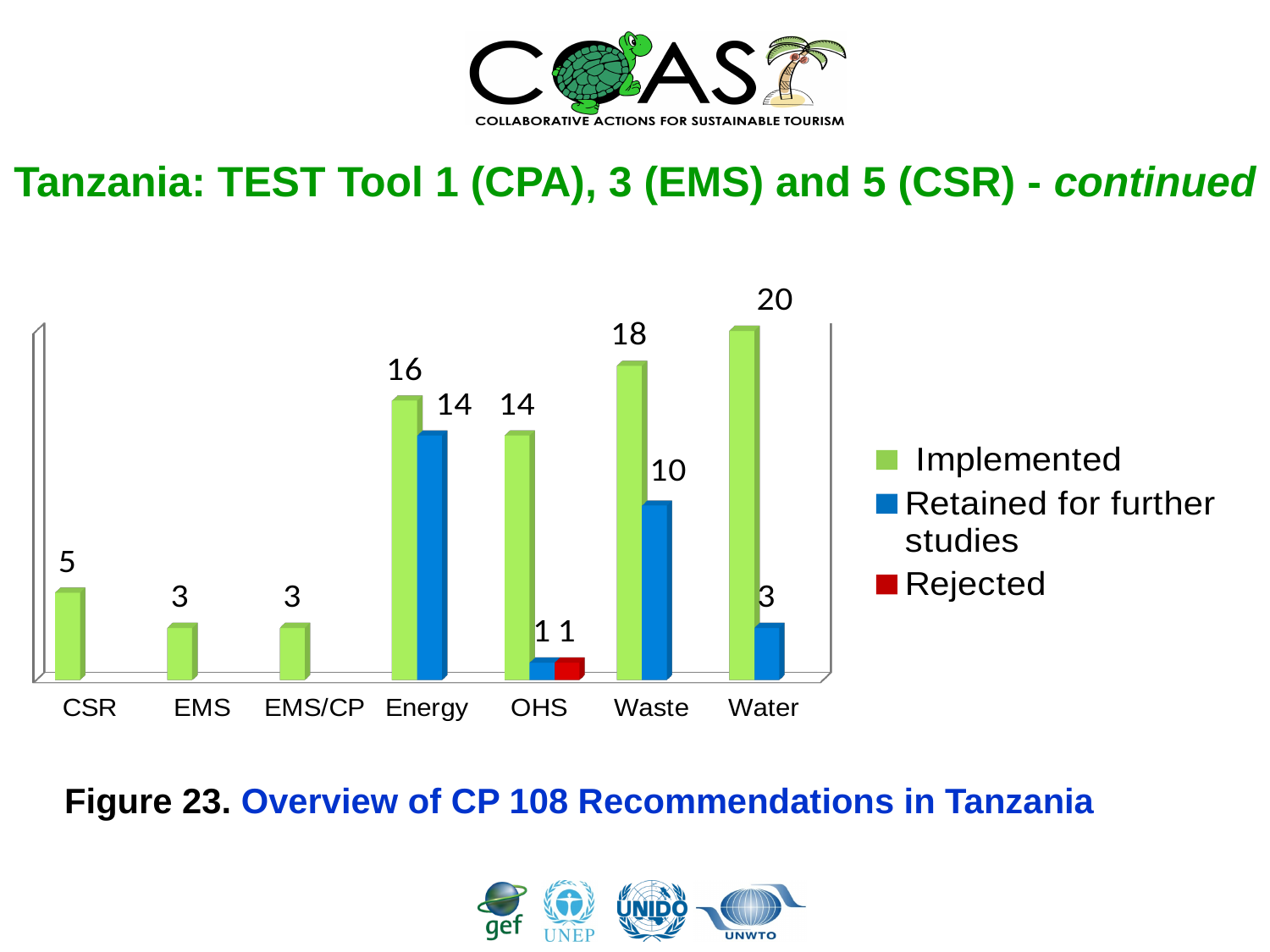
What kind of chart is shown on the slide? Bar chart Which is larger: the Implemented value for CSR or the Implemented value for EMS? CSR Which category has the lowest Retained for further studies value among those with a labelled blue bar? OHS How many series does the legend list? 3 What is the difference between the Implemented values for Waste and Energy? 2 What is the Retained for further studies value for Energy? 14 Which category has the highest Implemented value? Water What is the Implemented value for Water? 20 What is the difference between the Implemented and Retained for further studies values for Waste? 8 What is the Rejected value for OHS? 1 How many categories are shown on the x axis? 7 What is the figure caption of the chart? Figure 23. Overview of CP 108 Recommendations in Tanzania